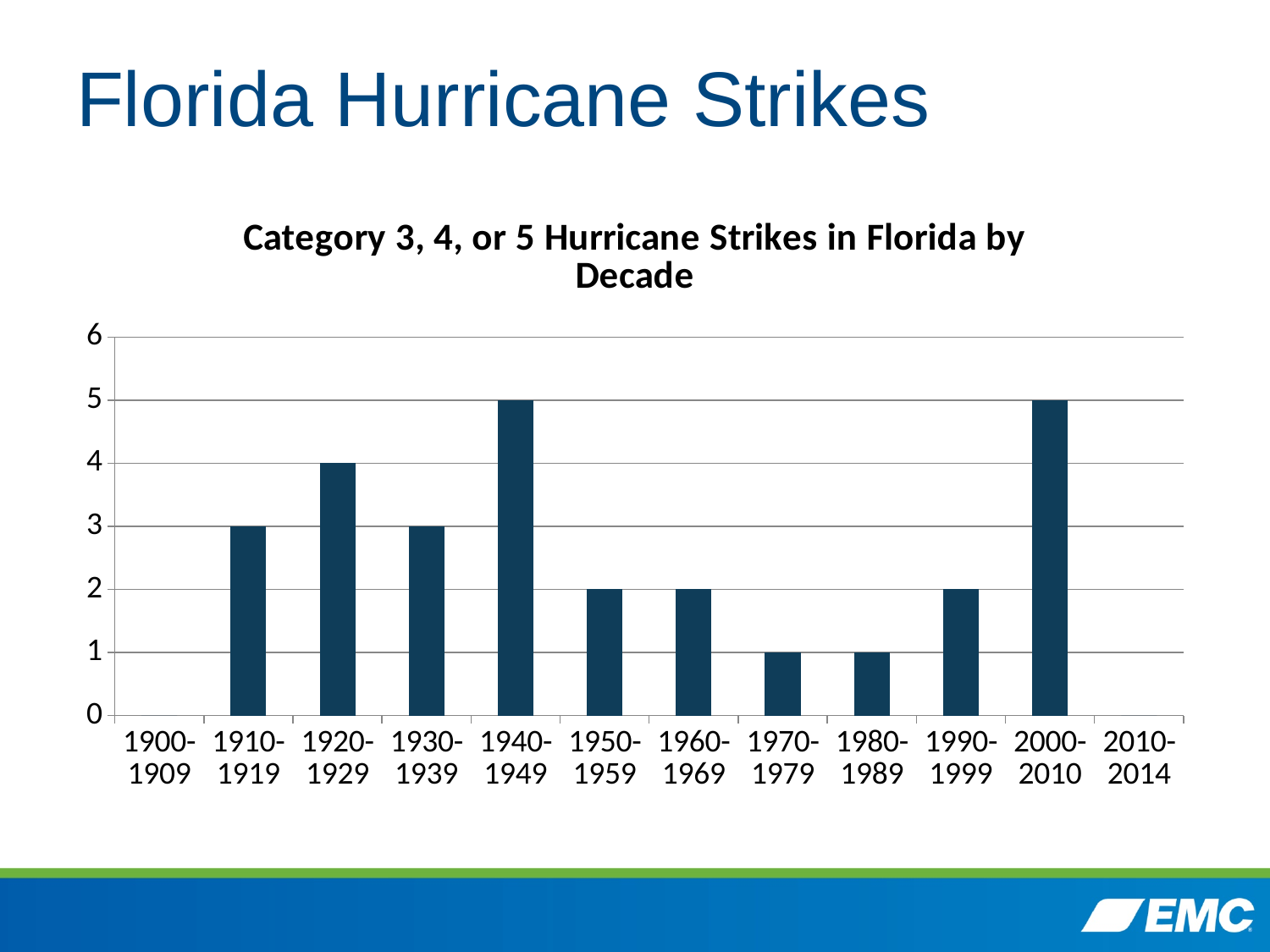
How many hurricane strikes are shown for 1920-1929? 4 Which has more hurricane strikes, 1920-1929 or 1930-1939? 1920-1929 How many hurricane strikes are shown for 2000-2010? 5 Is the value for 1910-1919 greater or less than 2? greater What kind of chart is shown on the slide? Bar chart How many hurricane strikes are shown for 1990-1999? 2 Do the values rise or fall from 1940-1949 to 1980-1989? Fall How many hurricane strikes are shown for 1940-1949? 5 What is the title of the chart? Category 3, 4, or 5 Hurricane Strikes in Florida by Decade How many hurricane strikes are shown for 1970-1979? 1 How many decade categories are shown on the x axis? 12 What is the difference in hurricane strikes between 1920-1929 and 1970-1979? 3